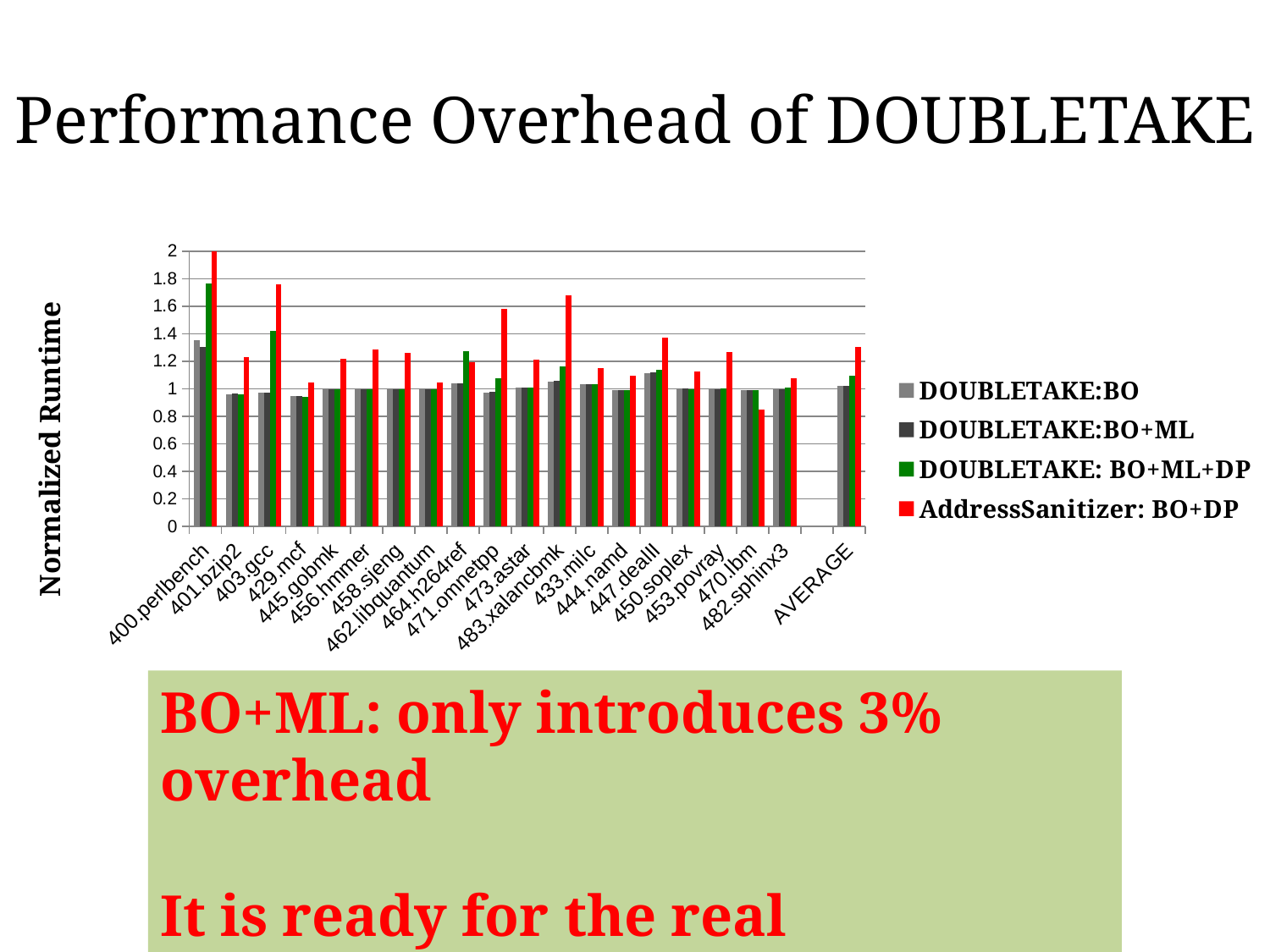
What is the label of the y axis? Normalized Runtime For which benchmark is the AddressSanitizer: BO+DP bar the lowest? 470.lbm For which benchmark is the AddressSanitizer: BO+DP bar the highest? 400.perlbench Is the AddressSanitizer: BO+DP value for 403.gcc greater or less than 1.6? greater Is the AddressSanitizer: BO+DP value for 400.perlbench greater or less than 1.8? greater For 403.gcc, which is larger: the DOUBLETAKE: BO+ML+DP value or the AddressSanitizer: BO+DP value? AddressSanitizer: BO+DP Is the AddressSanitizer: BO+DP value for 470.lbm greater or less than 1? less What kind of chart is shown on the slide? bar chart How many categories are shown along the x axis, including AVERAGE? 20 Which series is drawn in red? AddressSanitizer: BO+DP How many series does the legend list? 4